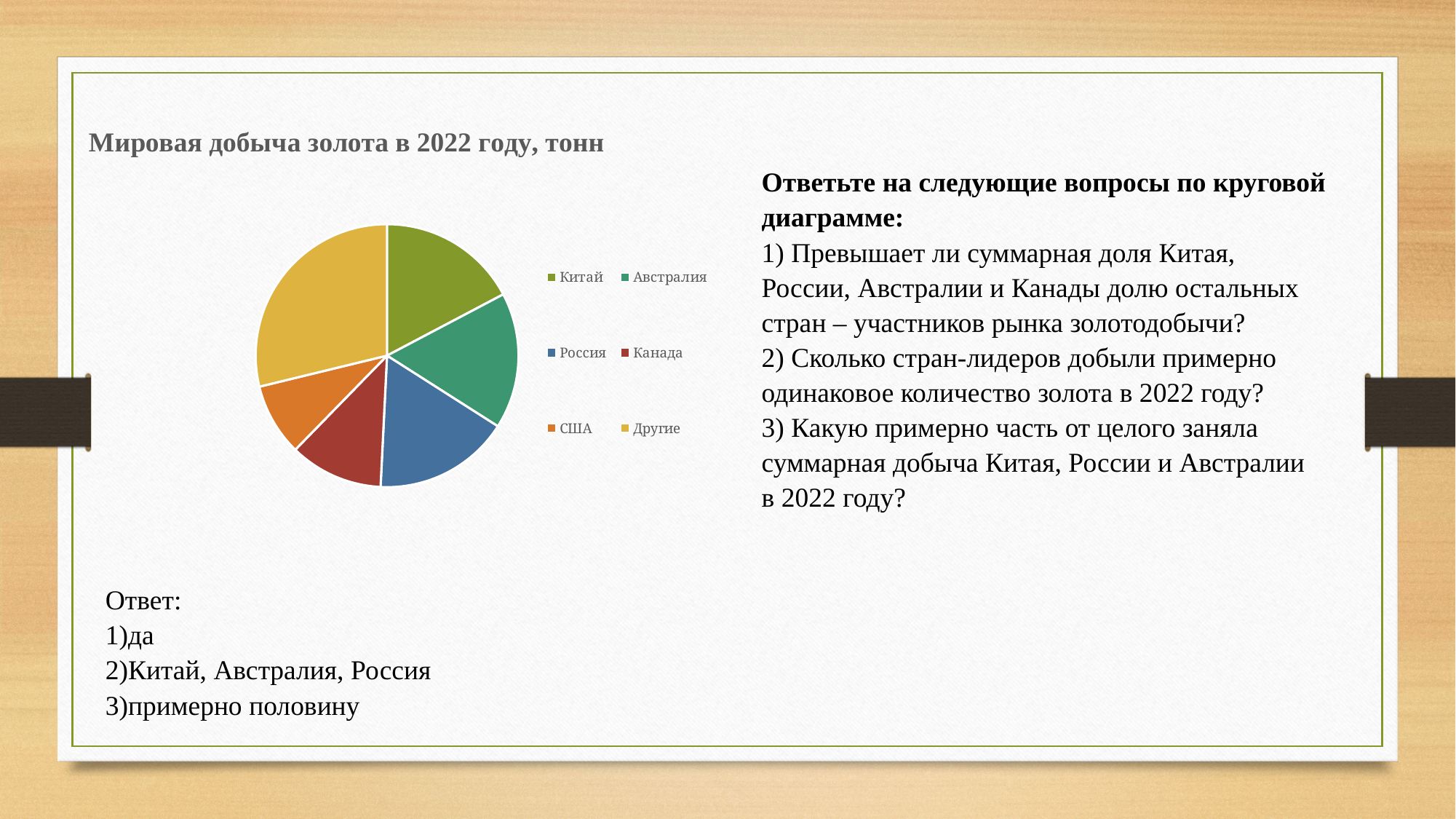
Which slice is larger, Россия or США? Россия Which slice is larger, Канада or США? Канада Which category has the largest slice of the pie? Другие What colour is the slice for Другие? yellow What is the title of the chart? Мировая добыча золота в 2022 году, тонн Which slice is larger, Австралия or Канада? Австралия Which category has the smallest slice of the pie? США How many slices does the pie chart have? 6 What kind of chart is shown on the slide? pie chart